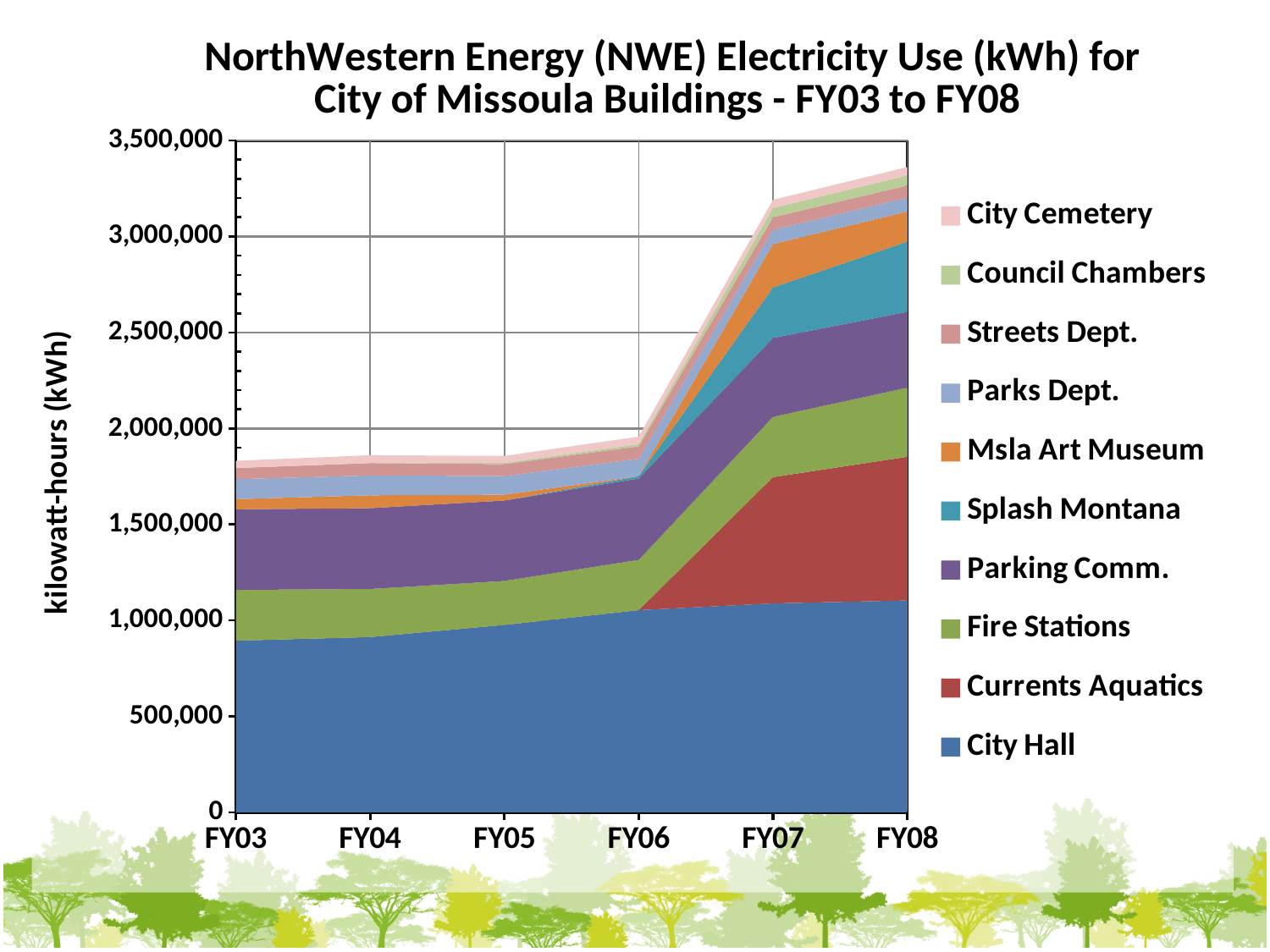
Does total electricity use rise or fall from FY03 to FY08? Rise Is the value for City Hall in FY03 greater or less than 1,000,000 kWh? less Is the total electricity use in FY03 greater or less than 2,000,000 kWh? less How many series does the legend list? 10 Which fiscal year has the higher total electricity use, FY03 or FY08? FY08 Which fiscal year has the lowest total electricity use? FY03 What kind of chart is shown on the slide? Stacked area chart What is the label on the y axis? kilowatt-hours (kWh) How many fiscal years are shown along the x axis? 6 Which series is listed last (at the bottom) in the legend? City Hall Is the total electricity use in FY08 greater or less than 3,000,000 kWh? greater